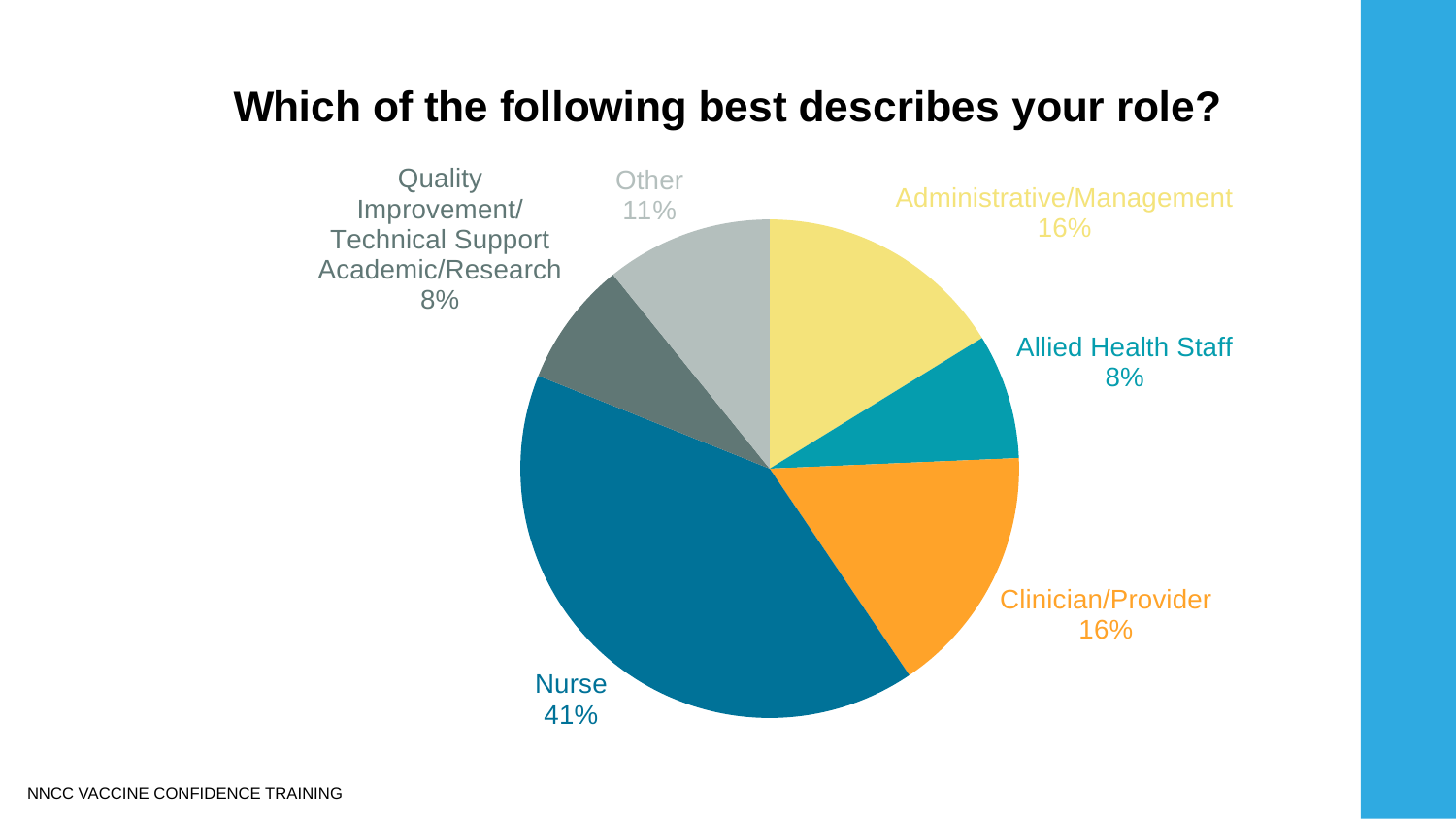
What is the difference between the Nurse share and the Clinician/Provider share? 25 percentage points What percentage of respondents selected Other? 11% How many slices does the pie chart have? 6 What colour is the Nurse slice? dark blue What percentage of respondents are in Administrative/Management roles? 16% What share of respondents are Nurses? 41% What is the chart's title? Which of the following best describes your role? What is the combined share of Administrative/Management and Clinician/Provider? 32% What share of respondents are Allied Health Staff? 8% Which is larger, the share for Other or the share for Allied Health Staff? Other Which role has the largest share of the pie? Nurse What kind of chart is shown on the slide? pie chart